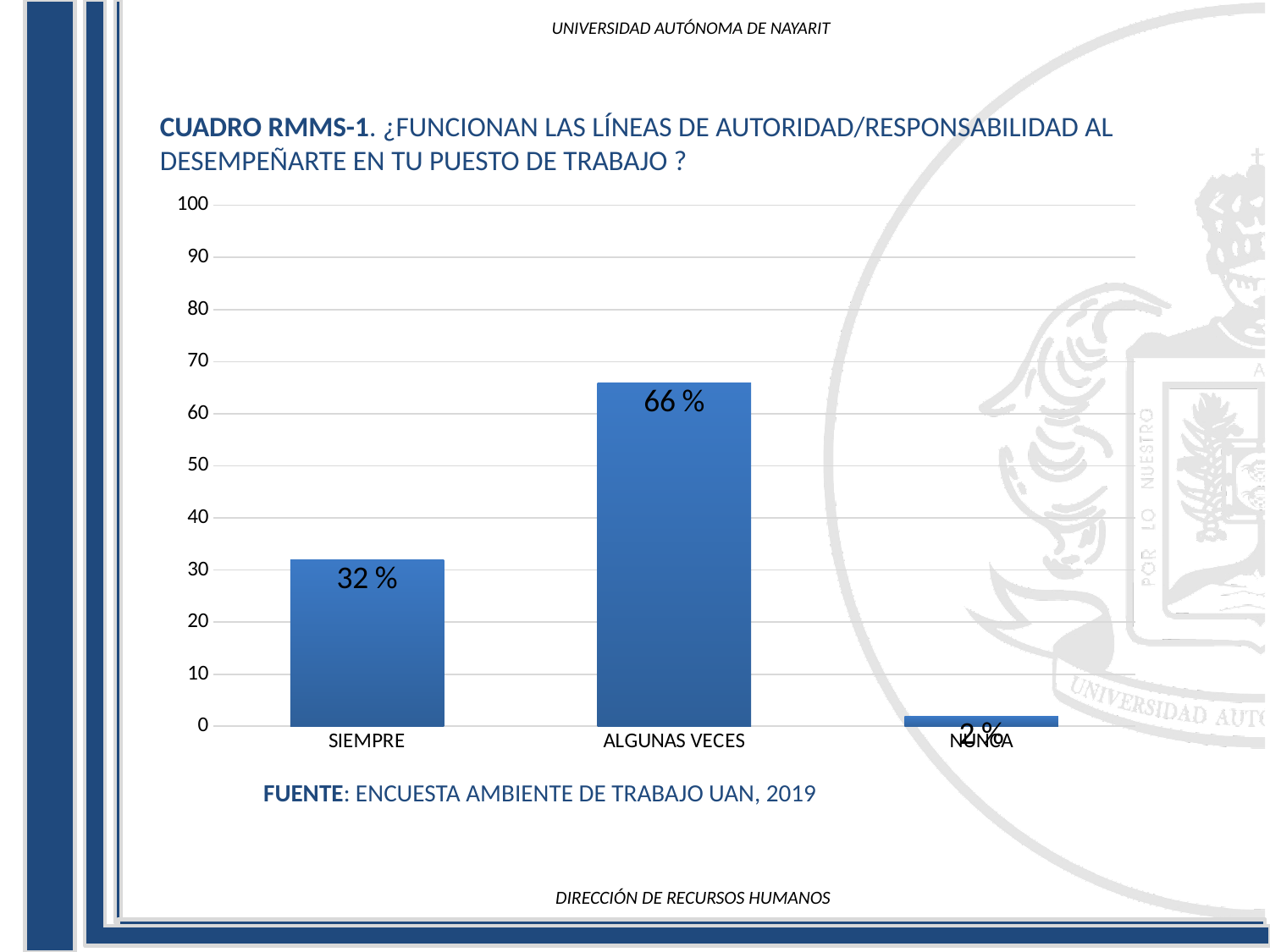
What is the value for NUNCA? 2 % Is the value for ALGUNAS VECES greater or less than 60? greater What is the value for ALGUNAS VECES? 66 % What is the value for SIEMPRE? 32 % How many categories are shown on the x axis? 3 What source is cited below the chart? ENCUESTA AMBIENTE DE TRABAJO UAN, 2019 Which category has the lowest value? NUNCA Is the value for SIEMPRE greater or less than 40? less Which category has the highest value? ALGUNAS VECES What is the difference between the values for ALGUNAS VECES and SIEMPRE? 34 % What kind of chart is shown on the slide? bar chart Which is larger, the value for SIEMPRE or the value for NUNCA? SIEMPRE